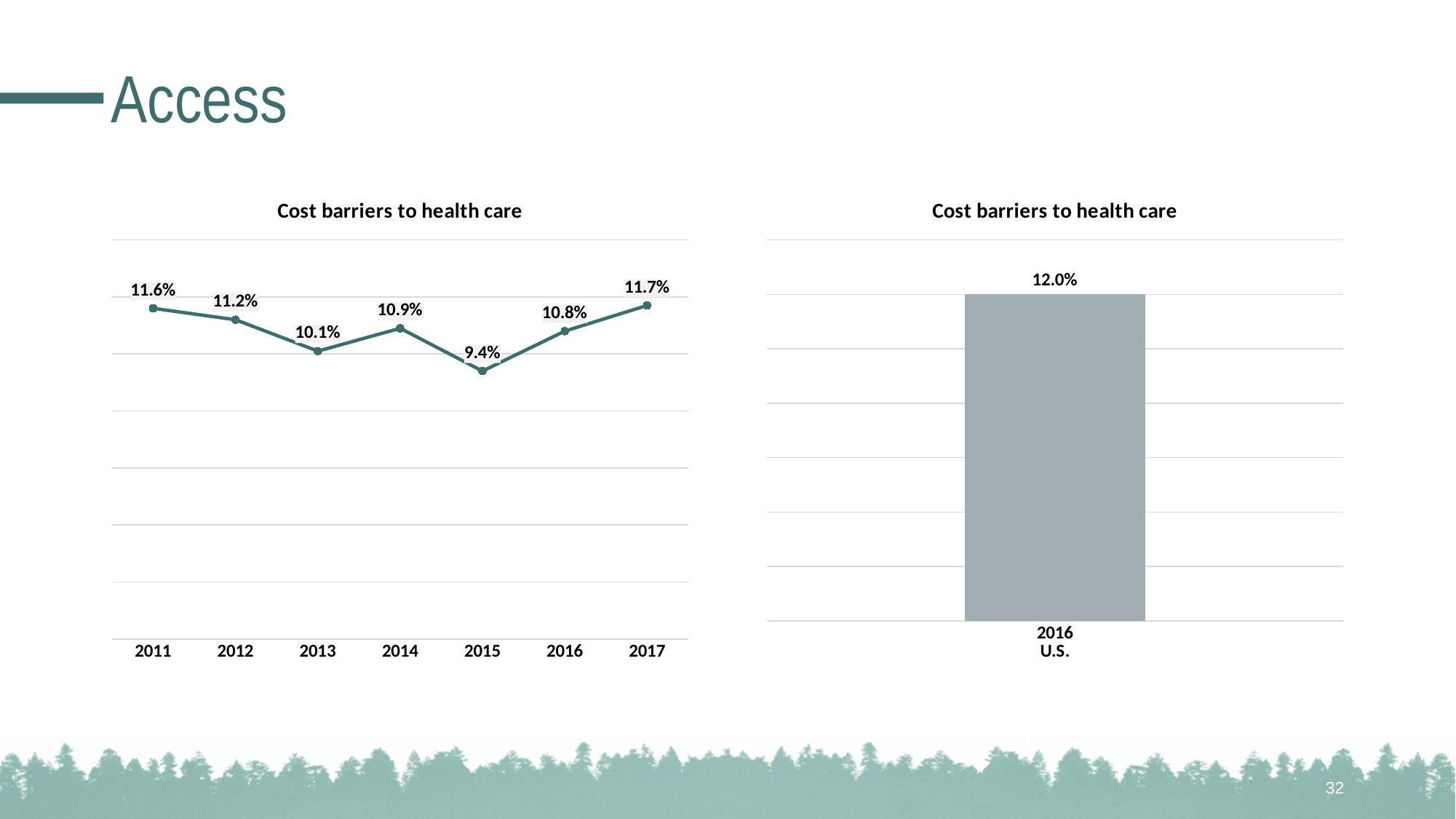
In the left chart (line chart), what is the value for 2015? 9.4% In the left chart (line chart), how many years are plotted? 7 In the left chart (line chart), what is the difference between the 2017 value and the 2015 value? 2.3% In the left chart (line chart), which year has the highest value? 2017 What kind of chart is the chart on the left? line chart In the left chart (line chart), which year has the lowest value? 2015 In the left chart (line chart), which is larger, the value for 2014 or the value for 2016? 2014 What is the title of the chart on the right? Cost barriers to health care In the left chart (line chart), do the values rise or fall from 2015 to 2017? rise In the right chart (bar chart), what is the value for 2016 U.S.? 12.0% In the left chart (line chart), what is the value for 2011? 11.6% What kind of chart is the chart on the right? bar chart